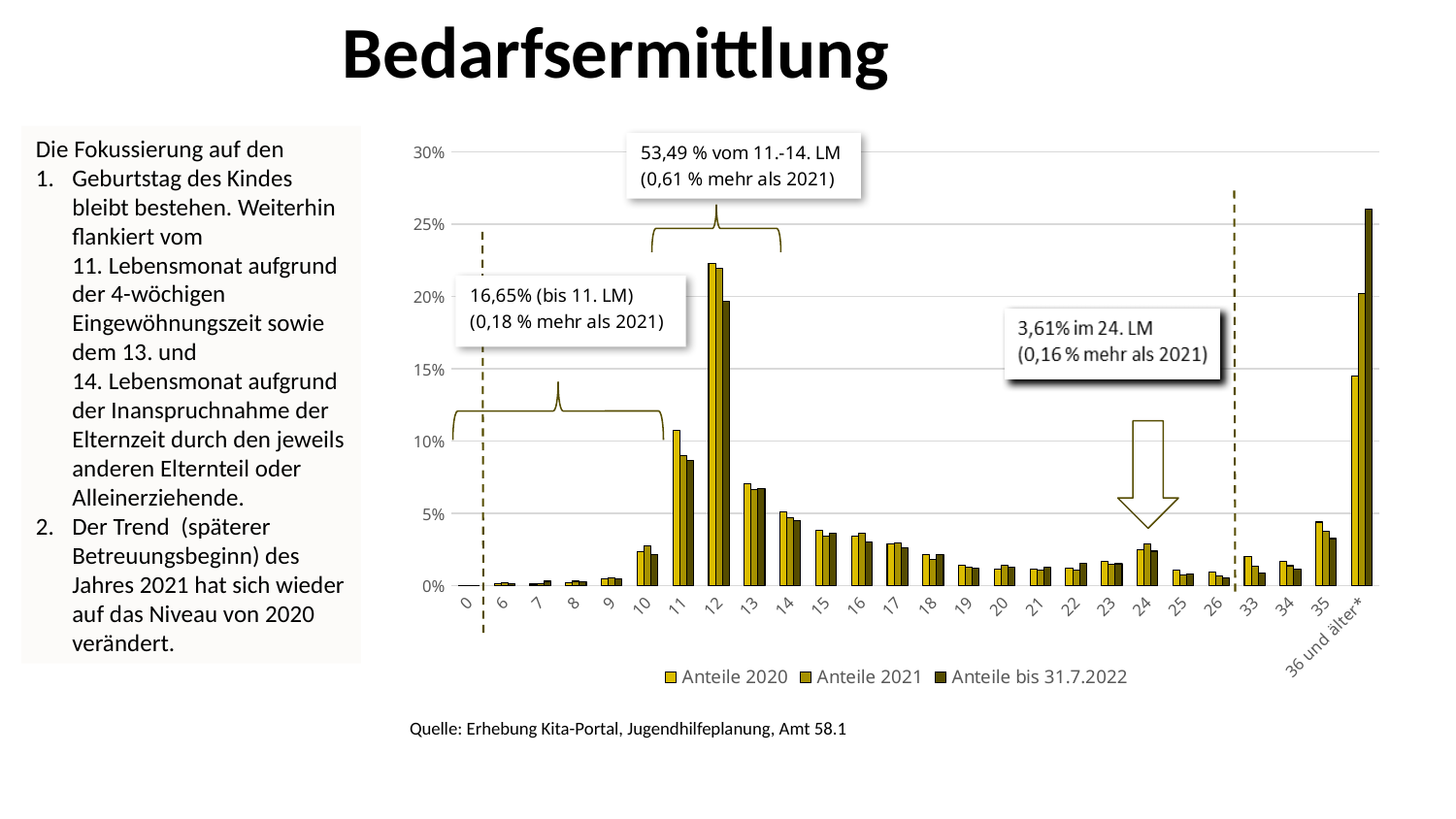
Which category has the highest value for the series Anteile bis 31.7.2022? 36 und älter* How many categories are shown on the x axis of the chart? 26 Is the value for category 13 in the series Anteile 2021 greater or less than 10%? less Which category has the highest value for the series Anteile 2020? 12 How many series does the chart legend list? 3 Do the values for Anteile 2020 rise or fall along the x axis from category 12 to category 26? fall For category 12, which series has the larger value: Anteile 2020 or Anteile bis 31.7.2022? Anteile 2020 For category 36 und älter*, which series has the larger value: Anteile 2020 or Anteile bis 31.7.2022? Anteile bis 31.7.2022 Is the value for category 12 in the series Anteile 2020 greater or less than 20%? greater Is the value for category 36 und älter* in the series Anteile bis 31.7.2022 greater or less than 20%? greater What kind of chart is shown on the slide? bar chart According to the annotation on the chart, what share is given for the 24th month (24. LM)? 3,61%